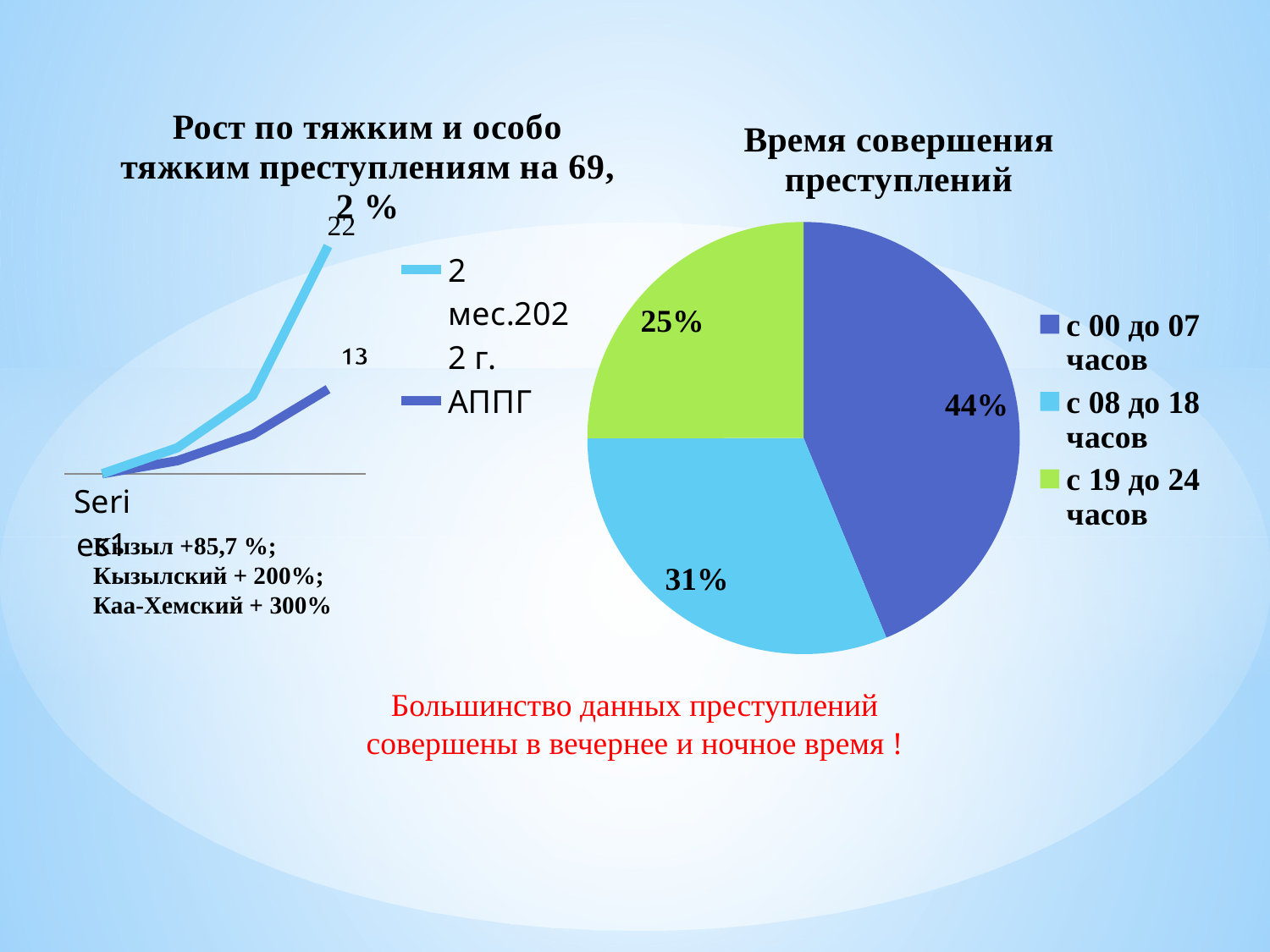
In the pie chart 'Время совершения преступлений', what share is shown for 'с 00 до 07 часов'? 44% In the pie chart 'Время совершения преступлений', which is larger: the slice for 'с 08 до 18 часов' or the slice for 'с 19 до 24 часов'? с 08 до 18 часов How many slices does the pie chart 'Время совершения преступлений' have? 3 In the pie chart 'Время совершения преступлений', what share is shown for 'с 08 до 18 часов'? 31% What kind of chart is the chart on the left of the slide, titled 'Рост по тяжким и особо тяжким преступлениям на 69,2 %'? Line chart In the pie chart 'Время совершения преступлений', what share is shown for 'с 19 до 24 часов'? 25% In the pie chart 'Время совершения преступлений', which time period has the smallest slice? с 19 до 24 часов How many series does the legend of the left chart 'Рост по тяжким и особо тяжким преступлениям на 69,2 %' list? 2 In the pie chart 'Время совершения преступлений', which time period has the largest slice? с 00 до 07 часов What kind of chart is the chart on the right of the slide? Pie chart In the left chart 'Рост по тяжким и особо тяжким преступлениям на 69,2 %', what is the difference between the final labelled values of the two series (22 and 13)? 9 In the pie chart 'Время совершения преступлений', how many percentage points larger is the 'с 00 до 07 часов' slice than the 'с 19 до 24 часов' slice? 19 percentage points